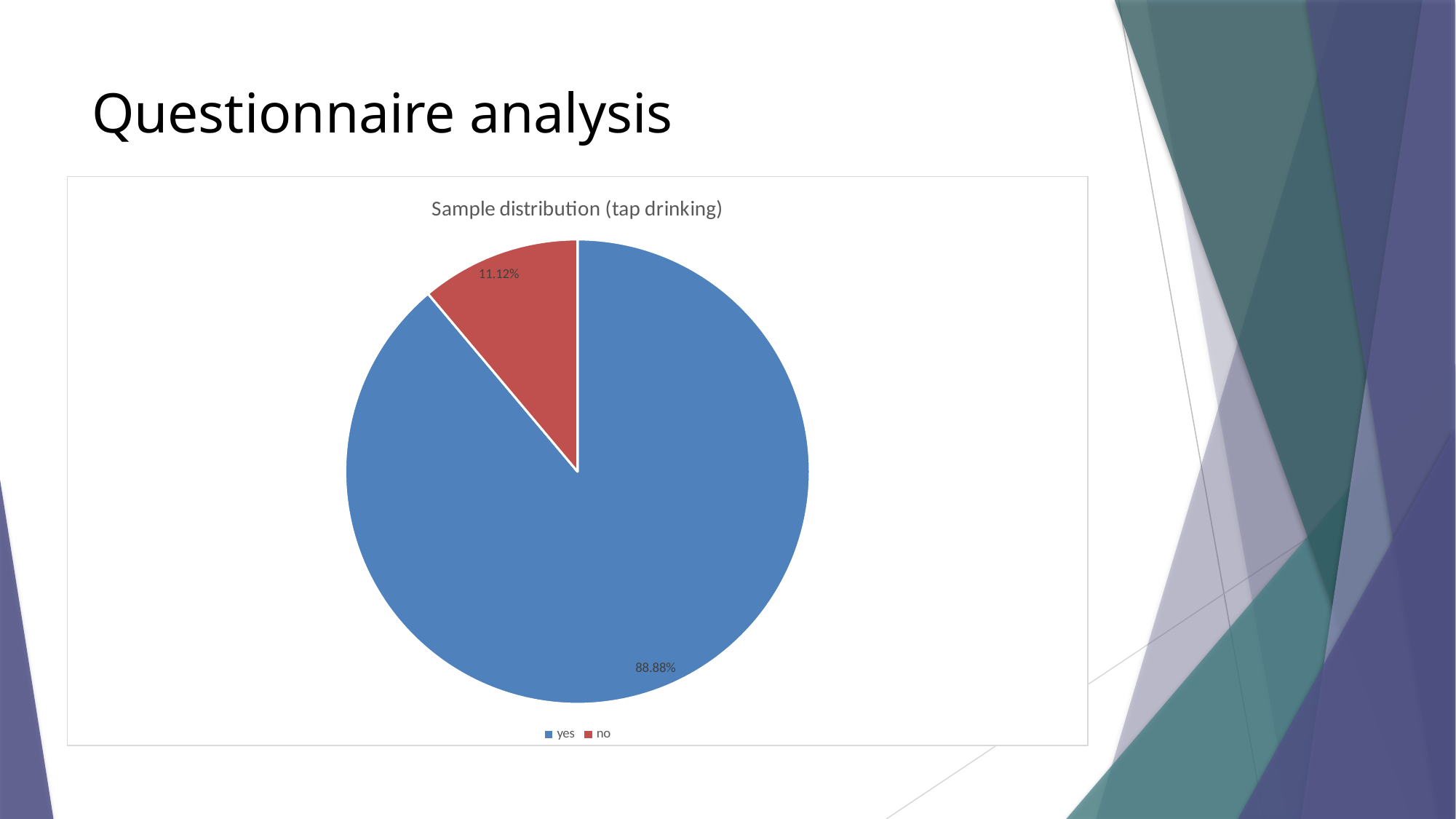
What is the difference in percentage points between the "yes" and "no" slices? 77.76 What share of the pie is labelled "no"? 11.12% What colour is the "no" slice? red What is the title of the chart? Sample distribution (tap drinking) How many slices does the pie chart have? 2 How many entries does the legend list? 2 Which slice is larger, "yes" or "no"? yes What share of the pie is labelled "yes"? 88.88% What kind of chart is shown on the slide? pie chart Which category has the largest slice of the pie? yes Which category has the smallest slice of the pie? no